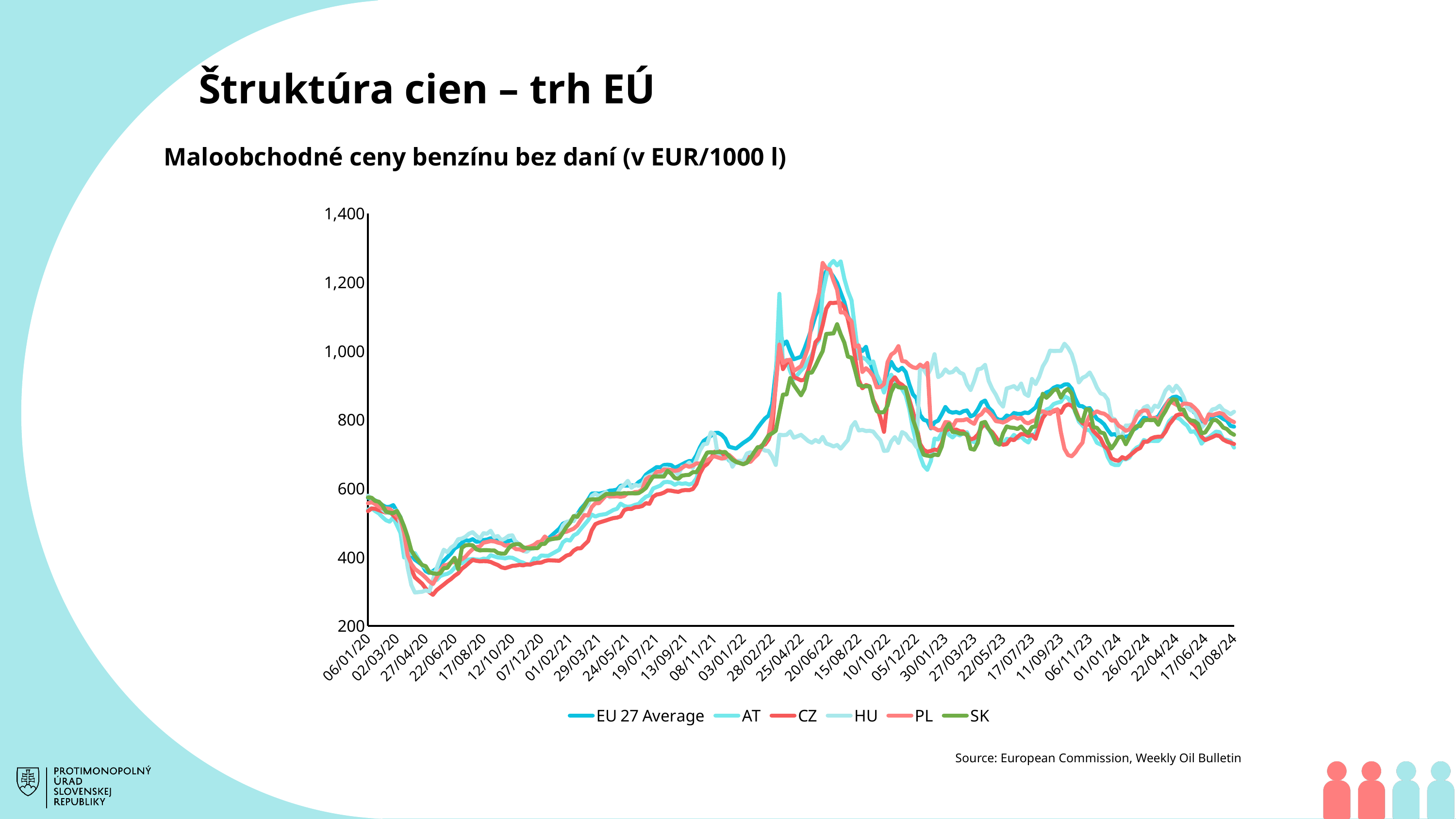
What is the source cited for the chart? European Commission, Weekly Oil Bulletin Which series is lowest around 20/06/22? HU Is the value for CZ around 20/06/22 greater or less than 1,200? less Which series is highest around 27/03/23? HU Is the value for EU 27 Average around 27/04/20 greater or less than 400? less What kind of chart is shown on the slide? line chart What is the title of the chart? Maloobchodné ceny benzínu bez daní (v EUR/1000 l) Does the EU 27 Average rise or fall between 27/04/20 and 20/06/22? rise How many series does the legend list? 6 Is the value for HU around 27/03/23 greater or less than 800? greater Does the EU 27 Average rise or fall between 20/06/22 and 05/12/22? fall